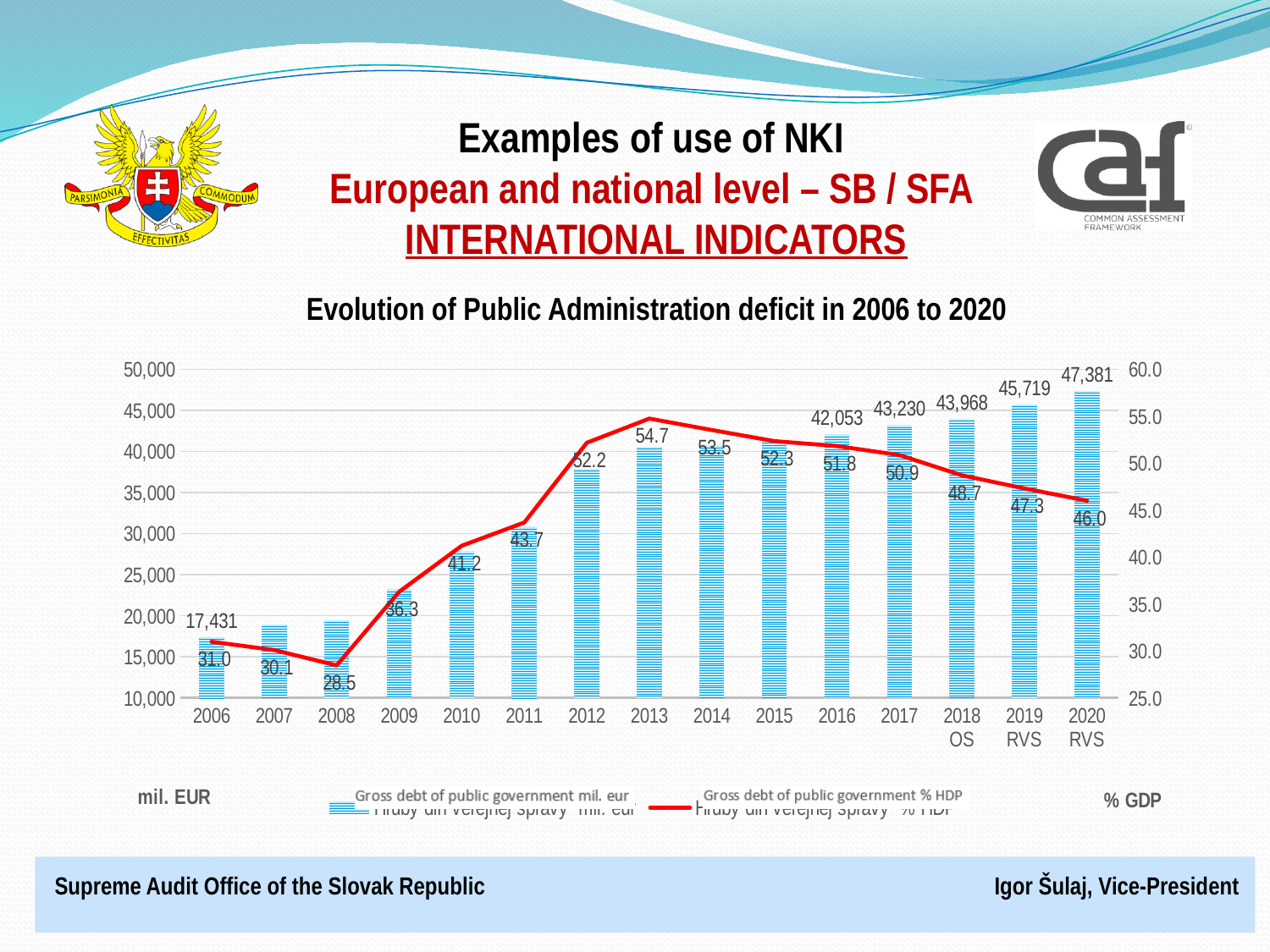
In which year is the gross debt of public government as % HDP lowest? 2008 What is the gross debt of public government in mil. EUR for 2020 RVS? 47,381 In which year is the gross debt of public government as % HDP highest? 2013 How many series does the chart legend list? 2 Which is larger, the gross debt as % HDP in 2014 or in 2015? 2014 What is the gross debt of public government as % HDP for 2013? 54.7 What is the gross debt of public government as % HDP for 2008? 28.5 Is the gross debt in mil. EUR for 2012 greater or less than 35,000? greater Does the gross debt as % HDP rise or fall from 2013 to 2020? fall What is the difference in gross debt in mil. EUR between 2020 RVS and 2019 RVS? 1,662 How many years are shown on the x axis of the chart? 15 What is the gross debt of public government in mil. EUR for 2006? 17,431